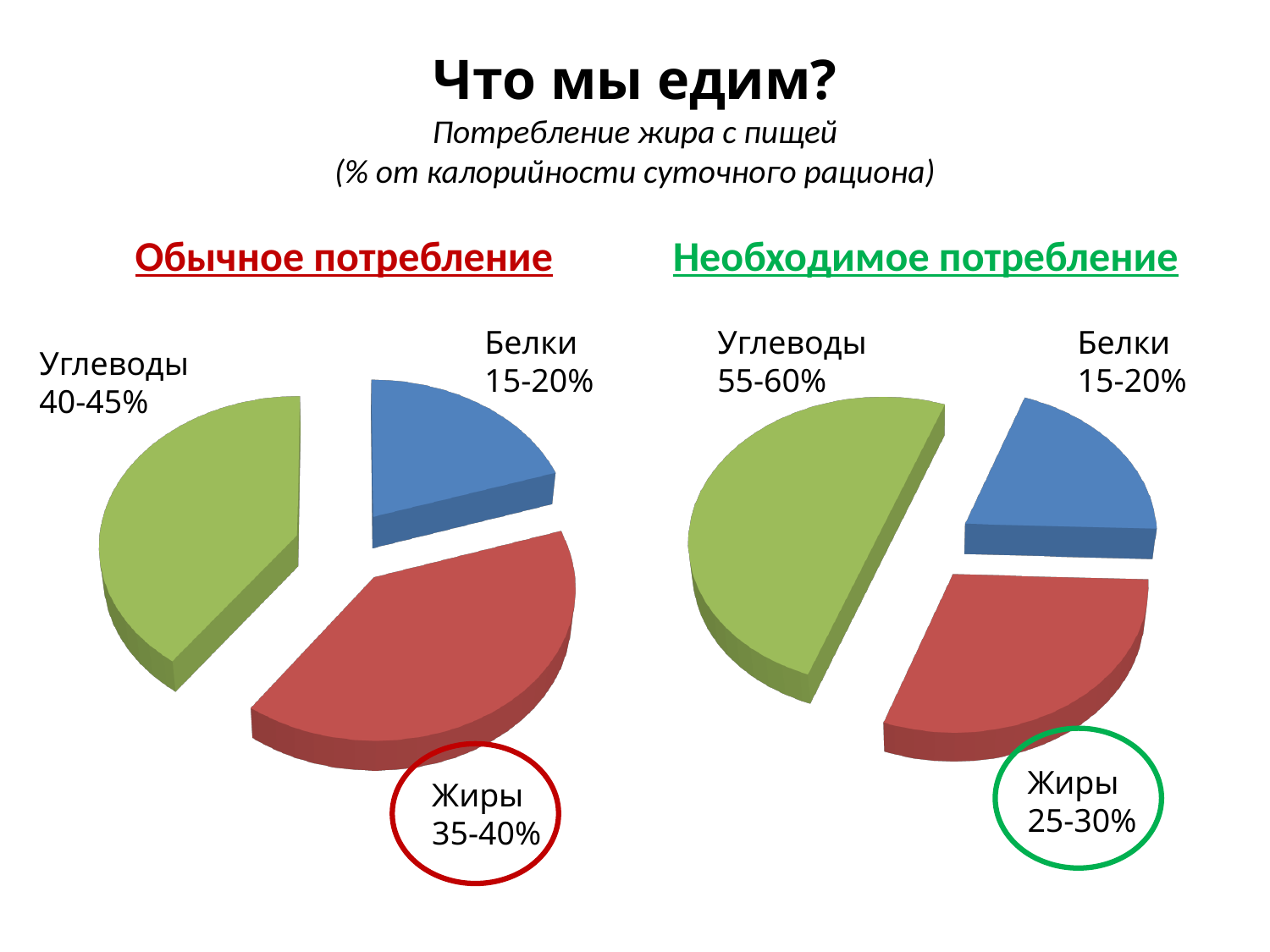
In the "Обычное потребление" chart, what is the value for Углеводы? 40-45% In the "Обычное потребление" chart, what is the value for Жиры? 35-40% What colour is the Жиры slice in the "Обычное потребление" chart? red In the "Необходимое потребление" chart, which category has the largest share? Углеводы In the "Необходимое потребление" chart, what is the value for Жиры? 25-30% How many slices does the "Необходимое потребление" pie chart have? 3 In the "Обычное потребление" chart, what is the value for Белки? 15-20% In the "Необходимое потребление" chart, what is the value for Белки? 15-20% In the "Обычное потребление" chart, which category has the smallest share? Белки What type of chart is used on the slide for "Обычное потребление"? pie chart In the "Обычное потребление" chart, which is larger: Жиры or Белки? Жиры In the "Необходимое потребление" chart, what is the value for Углеводы? 55-60%